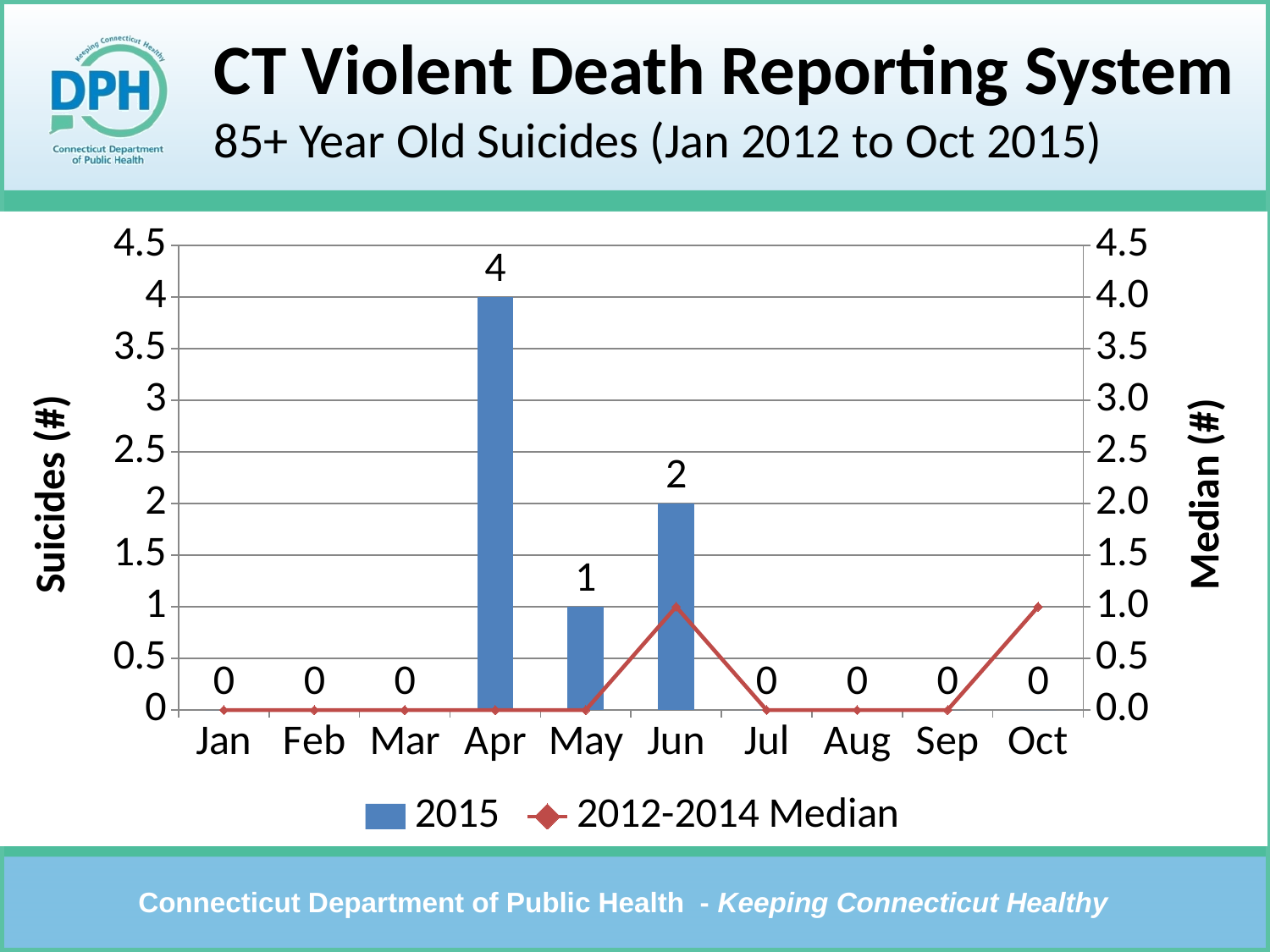
What is the 2015 value for June? 2 How many months are shown on the x axis? 10 Which is larger, the 2015 value for May or for June? Jun How many series does the legend list? 2 What is the 2015 value for May? 1 Is the 2012-2014 Median value for October greater or less than 0.5? greater What is the difference between the 2015 values for April and June? 2 How many suicides among 85+ year olds were reported in April 2015? 4 What type of chart is shown on the slide? Bar chart with a line series Which month has the highest number of 2015 suicides? Apr What is the 2012-2014 Median value for June? 1.0 What is the label of the left vertical axis? Suicides (#)